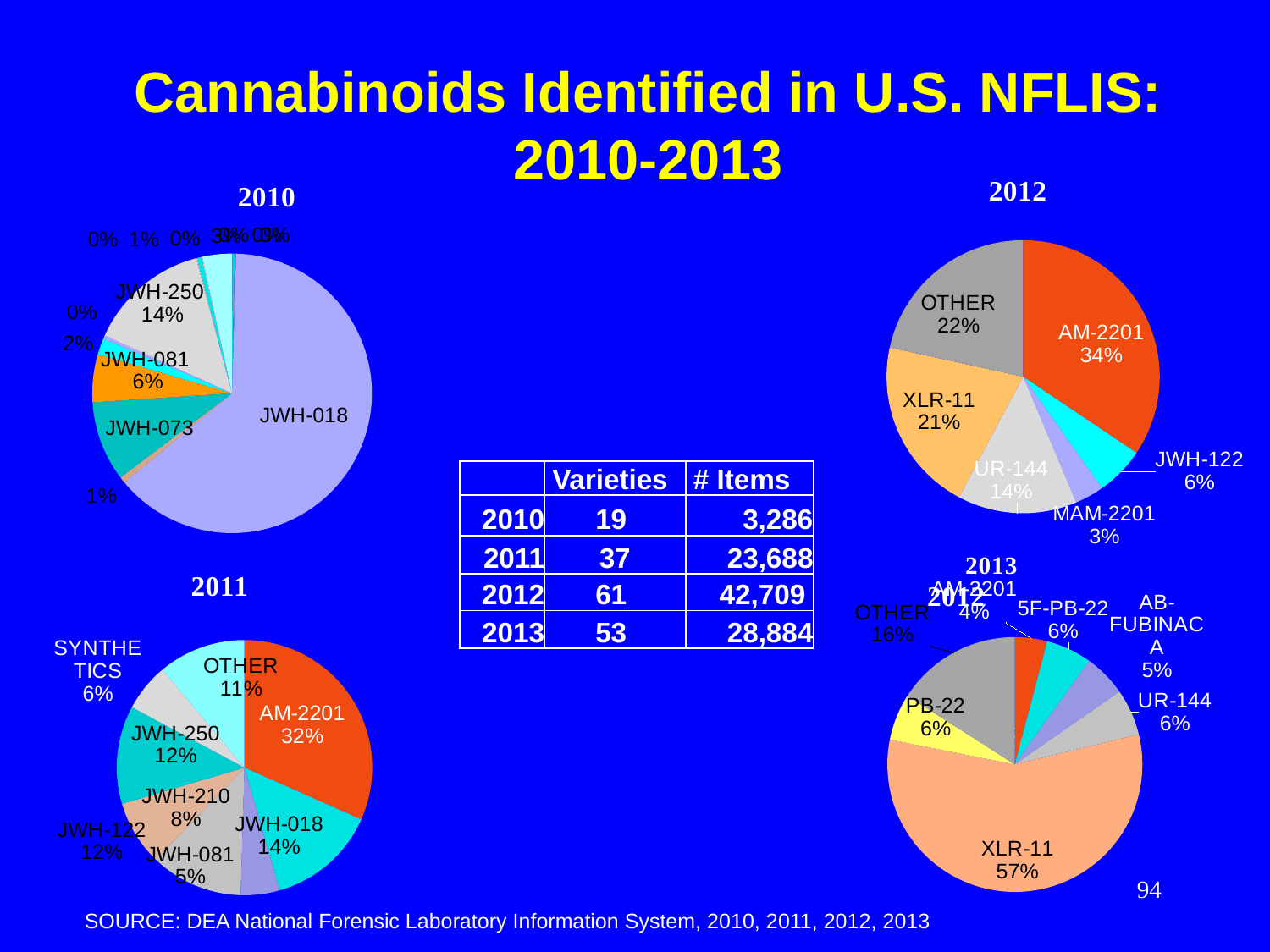
What kind of chart is used for the 2012 data on the slide? pie chart In the 2012 pie chart, what share does XLR-11 have? 21% In the 2010 pie chart, which cannabinoid has the largest slice? JWH-018 In the 2011 pie chart, what is the difference between the shares of AM-2201 and JWH-018? 18% In the 2013 pie chart, what share does OTHER have? 16% In the 2012 pie chart, which cannabinoid has the largest slice? AM-2201 In the 2013 pie chart, which labelled cannabinoid has the smallest share? AM-2201 In the 2012 pie chart, which is larger, the share of OTHER or the share of XLR-11? OTHER In the 2012 pie chart, what share does MAM-2201 have? 3%